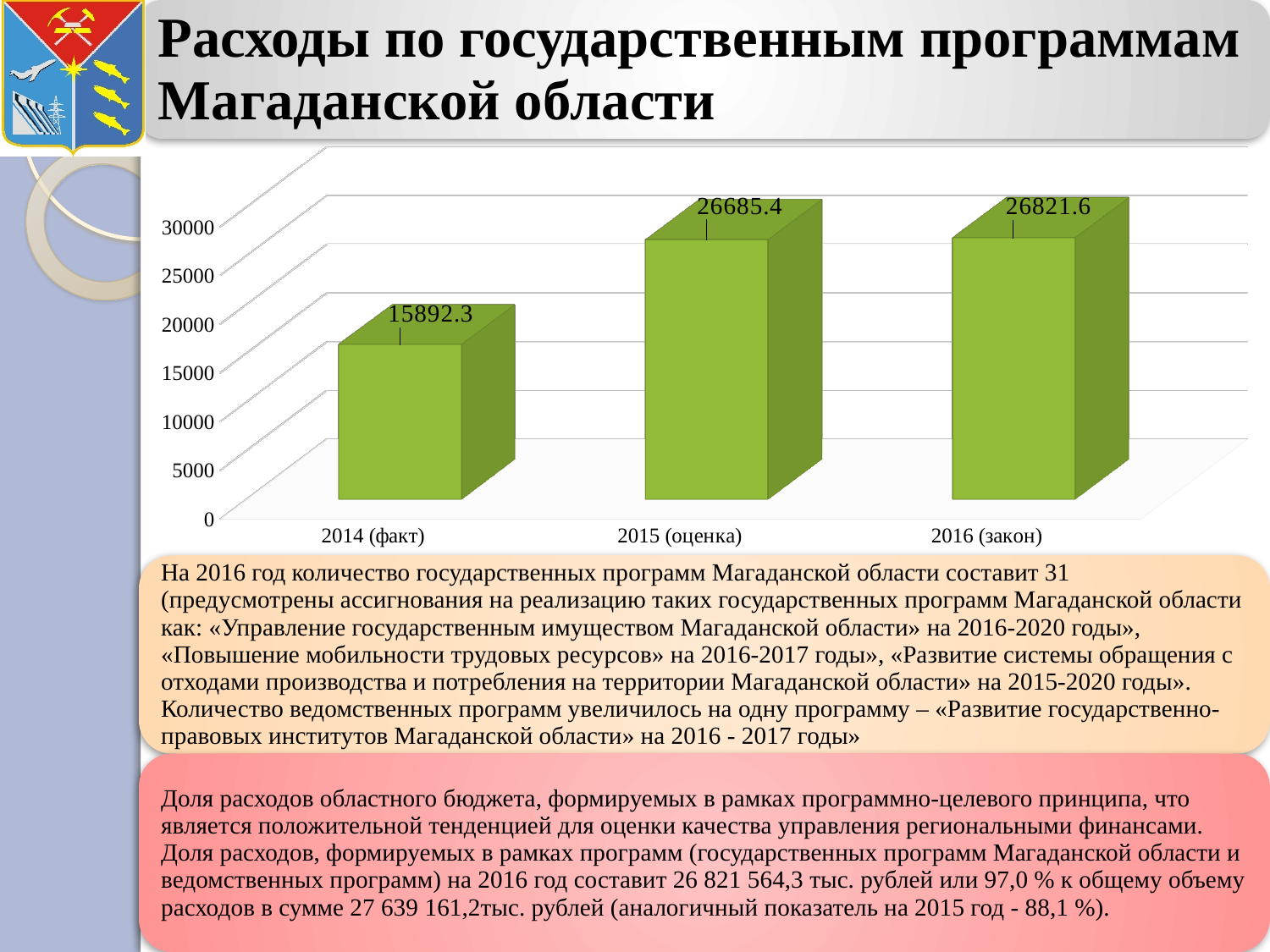
What is the value for 2014 (факт)? 15892.3 Which category has the lowest value? 2014 (факт) What is the difference between the values for 2015 (оценка) and 2014 (факт)? 10793.1 What is the difference between the values for 2016 (закон) and 2015 (оценка)? 136.2 What is the value for 2015 (оценка)? 26685.4 Which is larger, the value for 2014 (факт) or the value for 2015 (оценка)? 2015 (оценка) How many categories are shown on the x axis? 3 What kind of chart is shown on the slide? bar chart Is the value for 2014 (факт) greater or less than 20000? less Which category has the highest value according to the data labels? 2016 (закон) Do the values rise or fall from 2014 (факт) to 2016 (закон)? rise What is the value for 2016 (закон)? 26821.6